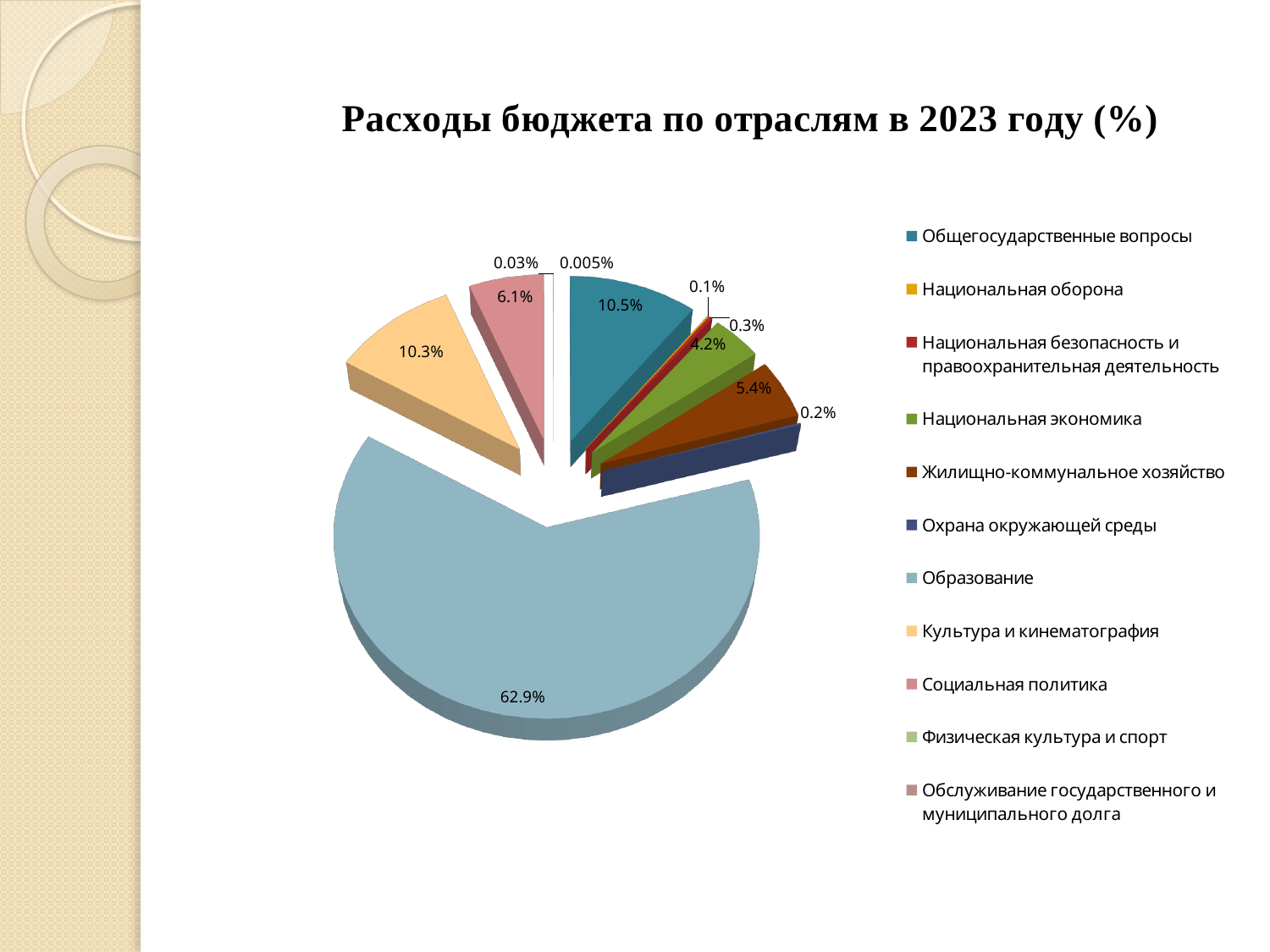
What is the difference between the shares of Социальная политика and Национальная экономика? 1.9% What kind of chart is shown on the slide? Pie chart Which category has the largest share of the pie? Образование How many categories does the legend list? 11 Which category has the smallest share of the pie? Обслуживание государственного и муниципального долга What is the value for Обслуживание государственного и муниципального долга? 0.005% What is the title of the chart? Расходы бюджета по отраслям в 2023 году (%) What is the value for Общегосударственные вопросы? 10.5% Which is larger, the share for Жилищно-коммунальное хозяйство or for Национальная экономика? Жилищно-коммунальное хозяйство What is the value for Жилищно-коммунальное хозяйство? 5.4% What is the value for Культура и кинематография? 10.3% What share of the budget goes to Образование? 62.9%